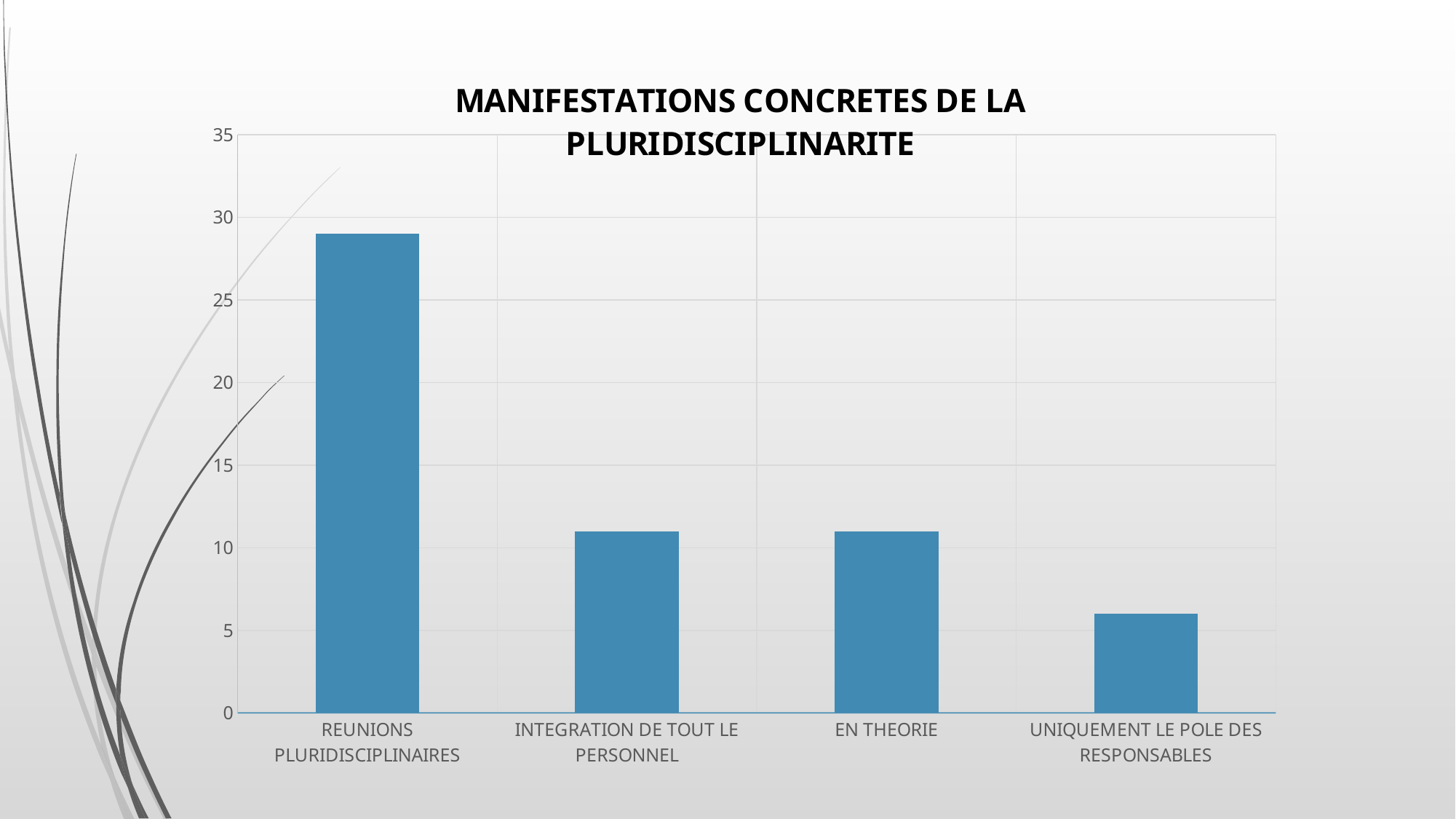
Which category has the highest value? REUNIONS PLURIDISCIPLINAIRES Do the values generally rise or fall from left to right along the x axis? fall Is the value for UNIQUEMENT LE POLE DES RESPONSABLES greater or less than 10? less Is the value for INTEGRATION DE TOUT LE PERSONNEL greater or less than 15? less How many categories are shown on the x axis of the chart? 4 Is the value for EN THEORIE greater or less than 15? less Which is larger, the value for REUNIONS PLURIDISCIPLINAIRES or the value for EN THEORIE? REUNIONS PLURIDISCIPLINAIRES What is the title of the chart? MANIFESTATIONS CONCRETES DE LA PLURIDISCIPLINARITE What kind of chart is shown on the slide? bar chart Which category has the lowest value? UNIQUEMENT LE POLE DES RESPONSABLES